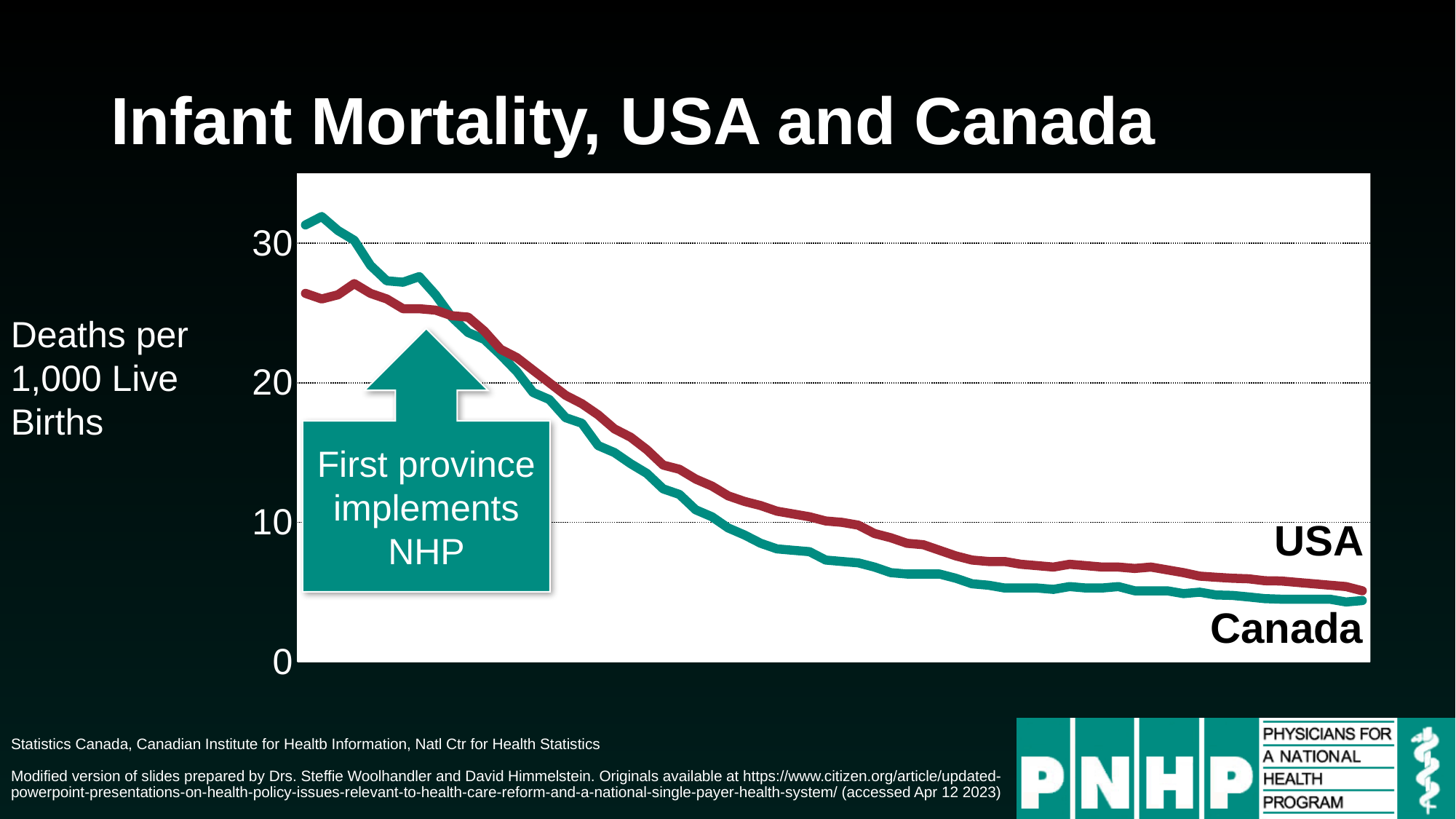
Do the infant mortality values for the USA rise or fall over time along the x axis? fall Which country's line is drawn in teal (green)? Canada Do the infant mortality values for Canada rise or fall over time along the x axis? fall Is Canada's infant mortality rate at the end of the chart greater or less than 10? less What kind of chart is shown on the slide? line chart How many series (countries) are plotted on the chart? 2 Is the USA's infant mortality rate at the end of the chart greater or less than 10? less At the start of the chart (left side), which country has the higher infant mortality rate, USA or Canada? Canada Is Canada's infant mortality rate at the start of the chart greater or less than 30? greater What is the title of the chart? Infant Mortality, USA and Canada What does the vertical axis measure, according to the label on the slide? Deaths per 1,000 Live Births